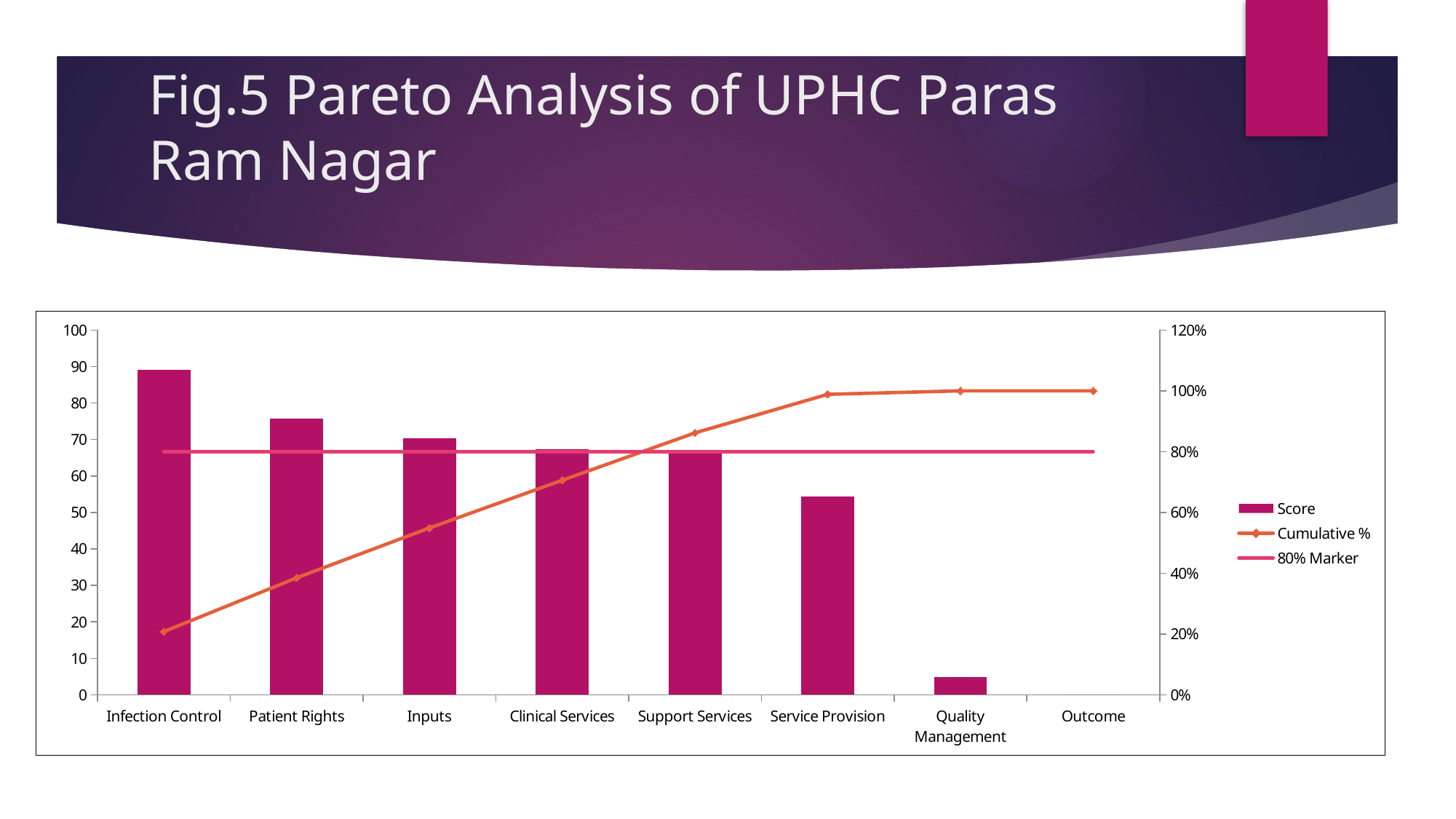
Which category has the lowest Score bar? Outcome Which category has the highest Score bar? Infection Control What type of chart is shown on the slide? bar chart (with line series) Do the Score bars rise or fall from left to right along the x axis? fall Is the Score for Service Provision greater or less than 60? less How many categories are shown on the x axis of the chart? 8 Is the Score for Inputs greater or less than 60? greater How many series does the chart legend list? 3 What are the three entries listed in the chart legend? Score, Cumulative %, 80% Marker Is the Score for Quality Management greater or less than 10? less Which has a higher Score, Patient Rights or Service Provision? Patient Rights